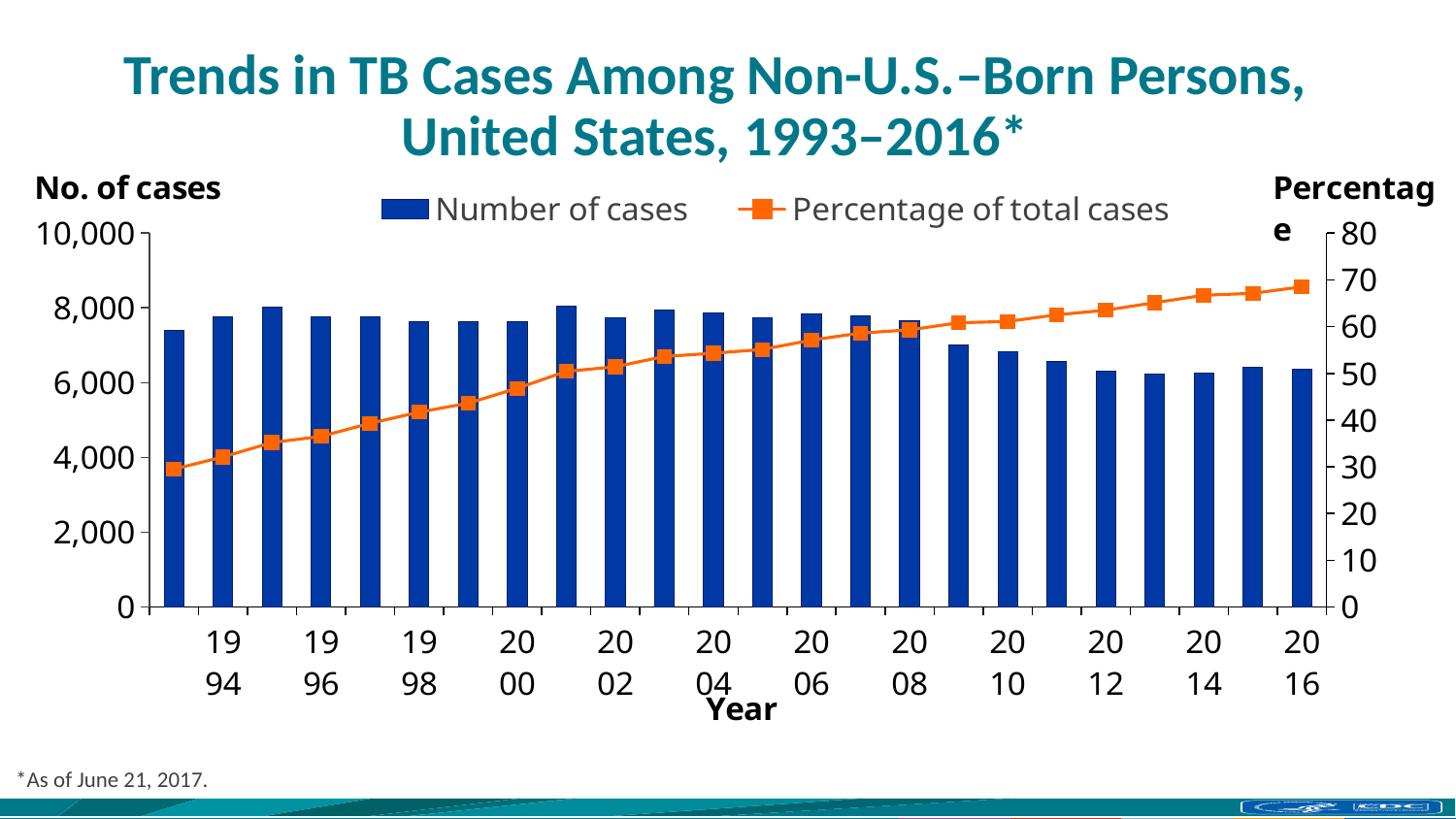
What is the label of the x axis? Year Is the percentage of total cases in 1994 greater or less than 40? less Which year has more cases, 2002 or 2014? 2002 How many years (bars) are plotted in the chart? 24 How many series does the legend list? 2 Is the number of cases in 1994 greater or less than 6,000? greater What are the two series named in the legend? Number of cases; Percentage of total cases Does the percentage of total cases rise or fall from 1994 to 2016? Rises Is the percentage of total cases in 2016 greater or less than 60? greater What kind of chart is shown on the slide? A combined bar and line chart In which year is the percentage of total cases highest? 2016